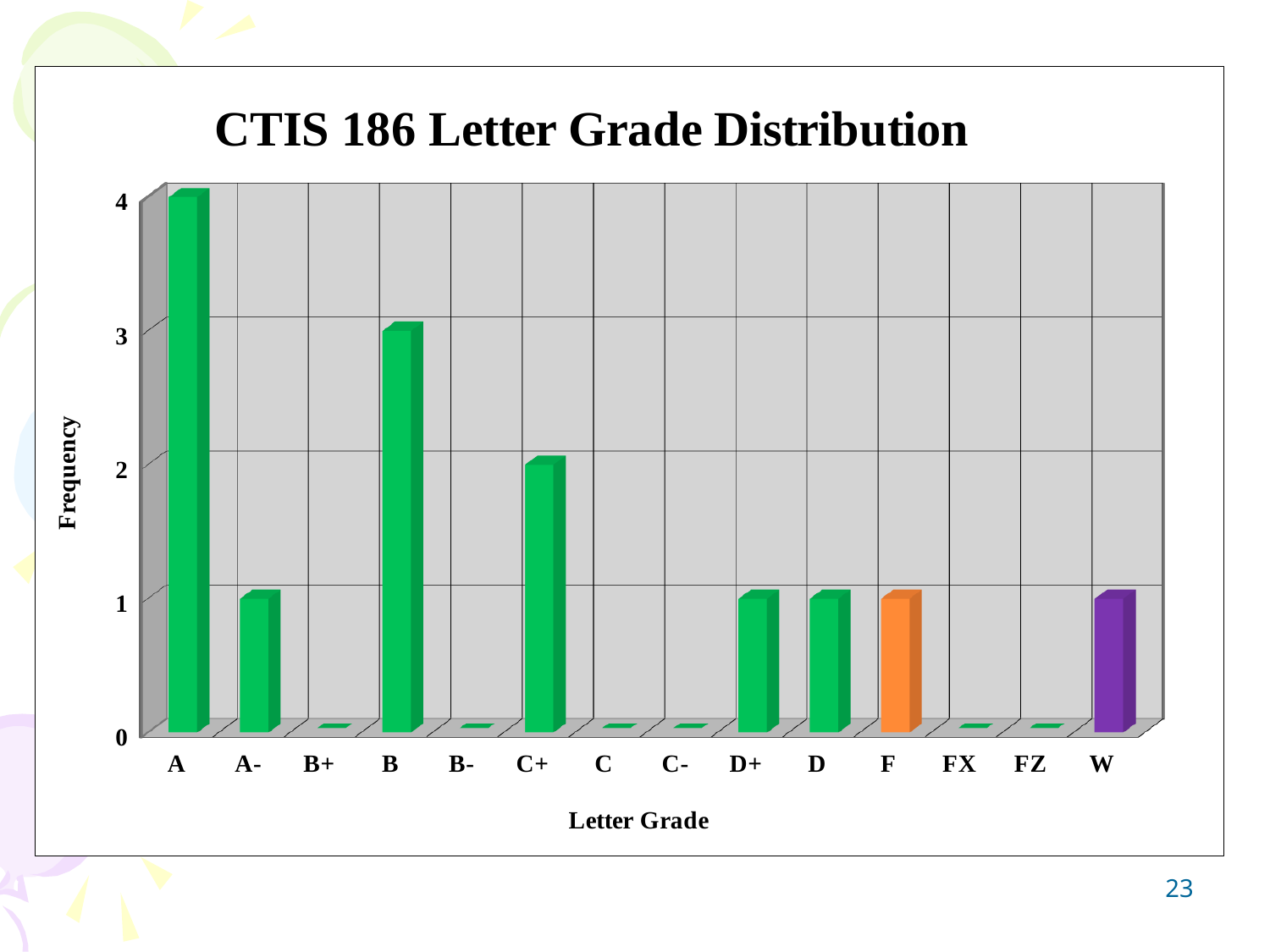
What is the label of the vertical axis? Frequency What is the frequency for letter grade B? 3 What is the title of the chart? CTIS 186 Letter Grade Distribution What is the frequency for letter grade A? 4 What is the frequency for letter grade C+? 2 What is the difference in frequency between letter grades A and B? 1 How many letter grade categories are shown on the x axis? 14 What is the frequency for letter grade B+? 0 What is the frequency for letter grade W? 1 Which letter grade has the highest frequency? A What type of chart is shown on the slide? bar chart Which has a higher frequency, B or C+? B